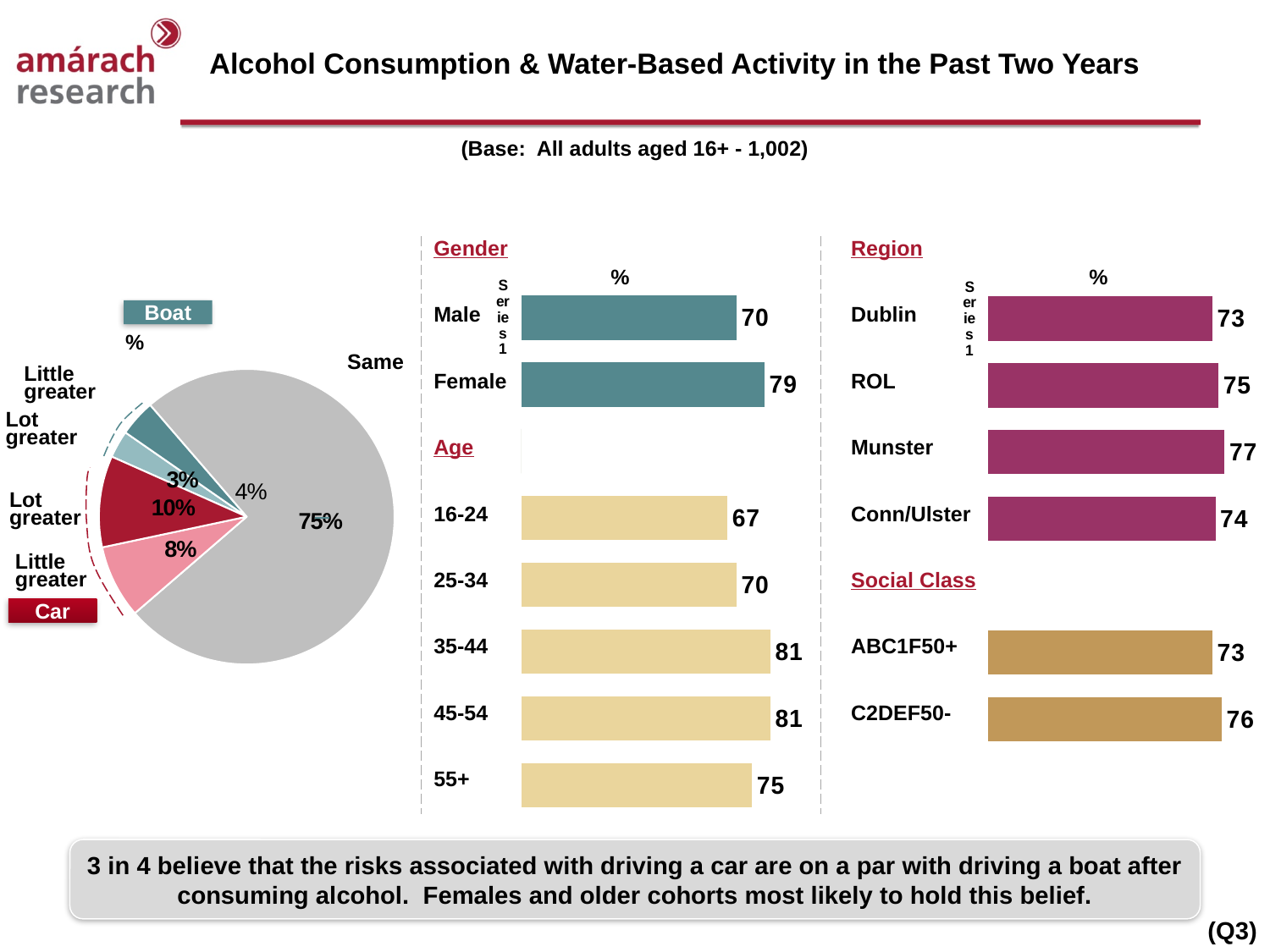
In the Gender bar chart, what is the difference between the Female and Male values? 9 In the Region bar chart, which region has the highest value? Munster In the Region bar chart, which is larger, ROL or Conn/Ulster? ROL In the Gender bar chart, what is the value for Male? 70 In the Age bar chart, how many age groups are shown? 5 In the Region bar chart, what is the value for Dublin? 73 In the Social Class bar chart, what is the difference between C2DEF50- and ABC1F50+? 3 In the Gender bar chart, what is the value for Female? 79 What type of chart is used for the Gender, Age, Region and Social Class breakdowns? Bar chart In the Age bar chart, what is the value for 55+? 75 In the pie chart, what share of respondents said the risk is the 'Same'? 75% In the Age bar chart, which age group has the lowest value? 16-24